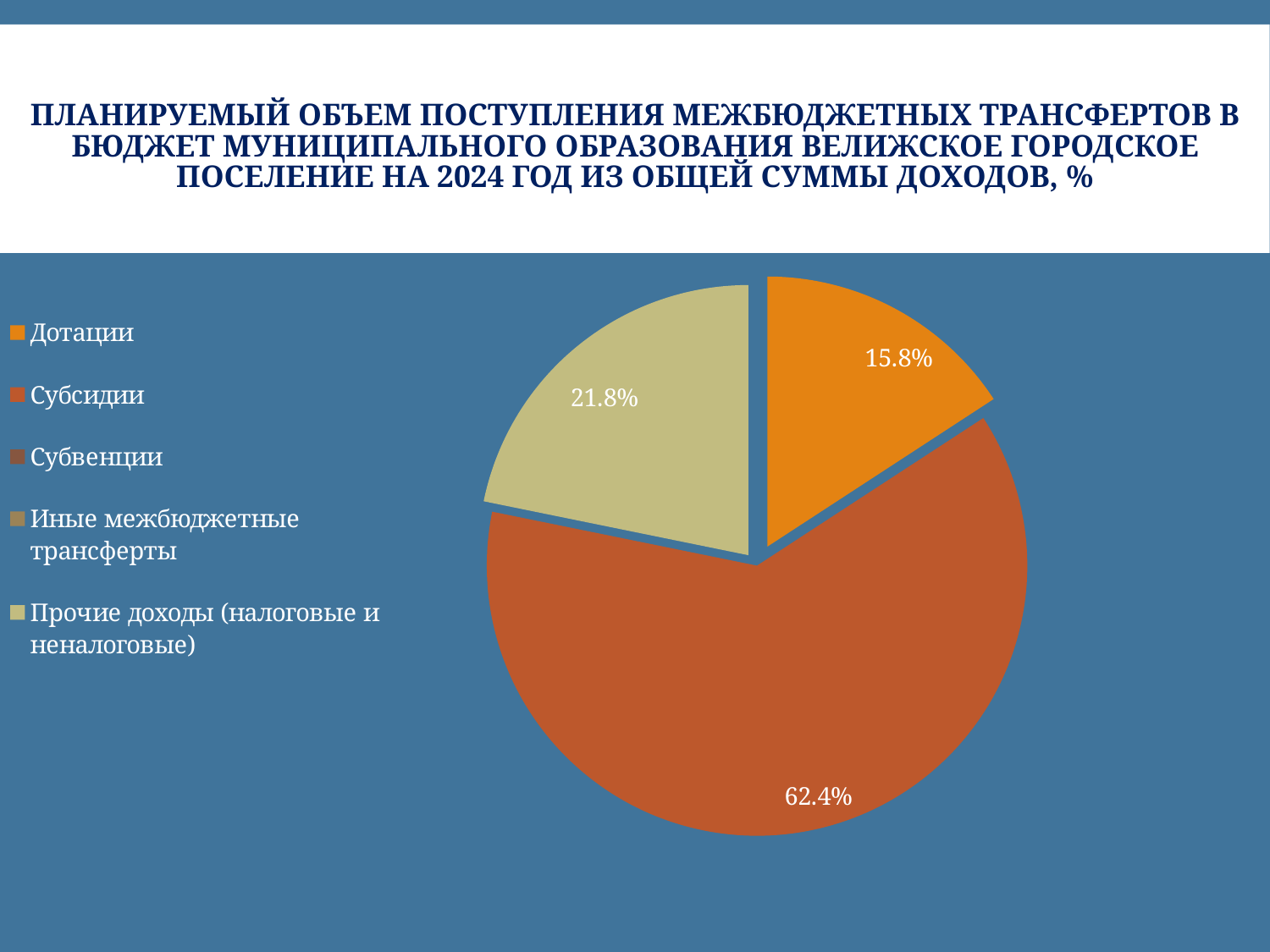
Is the share for Субсидии greater or less than 50%? greater How many entries does the legend list? 5 What is the difference between the Субсидии share and the Дотации share? 46.6% What colour is the Субсидии slice? dark orange-red Which category has the largest slice of the pie? Субсидии What share of the pie does Субсидии have? 62.4% What share of the pie does Прочие доходы (налоговые и неналоговые) have? 21.8% Which is larger, the share for Дотации or the share for Прочие доходы (налоговые и неналоговые)? Прочие доходы (налоговые и неналоговые) Which of the visible slices is the smallest? Дотации What type of chart is shown on the slide? pie chart How many slices with data labels are visible in the pie chart? 3 What share of the pie does Дотации have? 15.8%